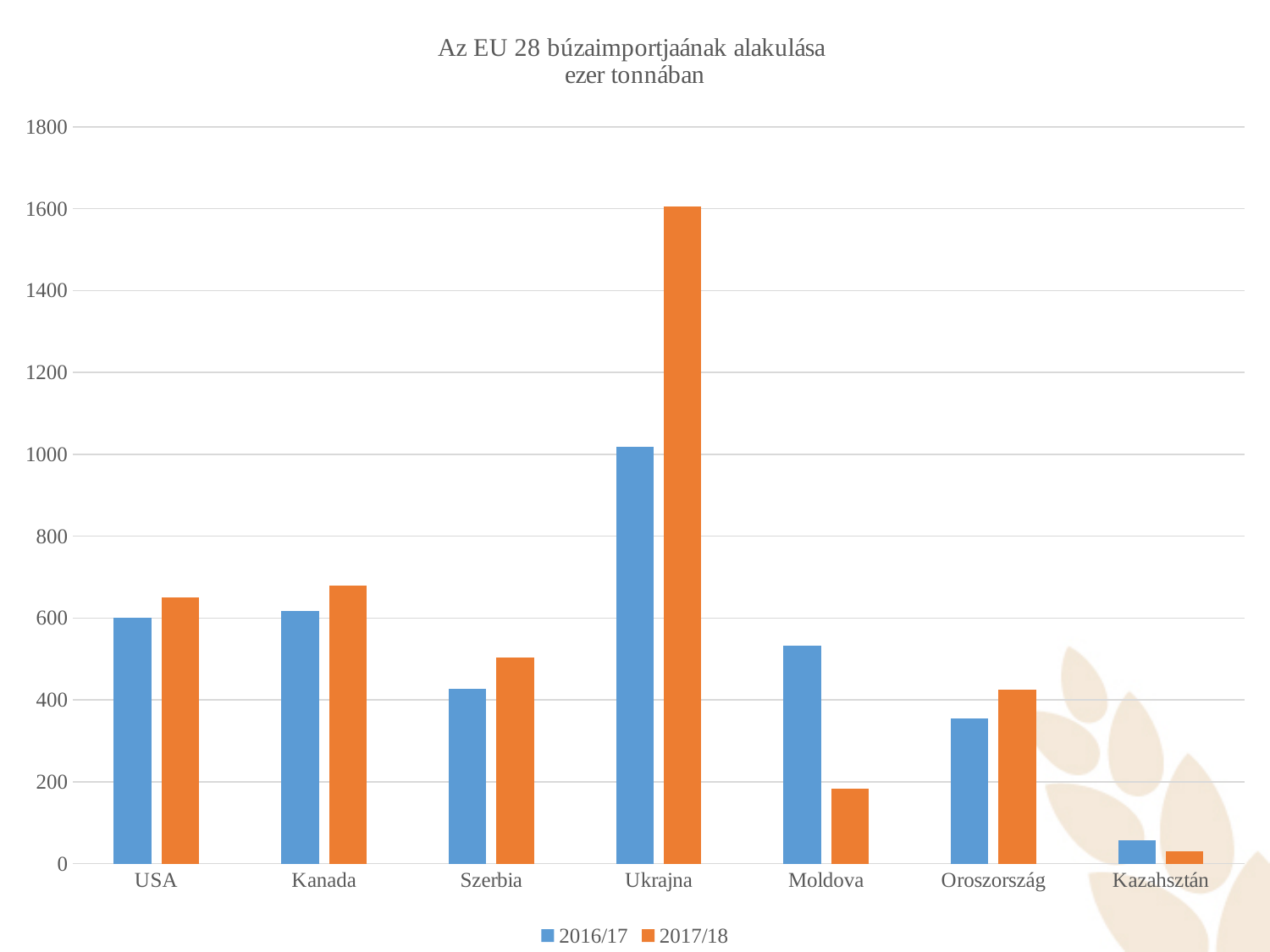
Which country has the lowest value for 2017/18? Kazahsztán How many countries are shown on the x axis? 7 Which country has the lowest value for 2016/17? Kazahsztán What is the title of the chart? Az EU 28 búzaimportjaának alakulása ezer tonnában Is the 2017/18 value for Moldova greater or less than 400? less Is the 2017/18 value for Ukrajna greater or less than 1400? greater How many series does the legend list? 2 Is the 2017/18 value for Kanada greater or less than 600? greater Which country has the highest value for 2017/18? Ukrajna For Moldova, which series has the larger value, 2016/17 or 2017/18? 2016/17 What kind of chart is shown on the slide? bar chart